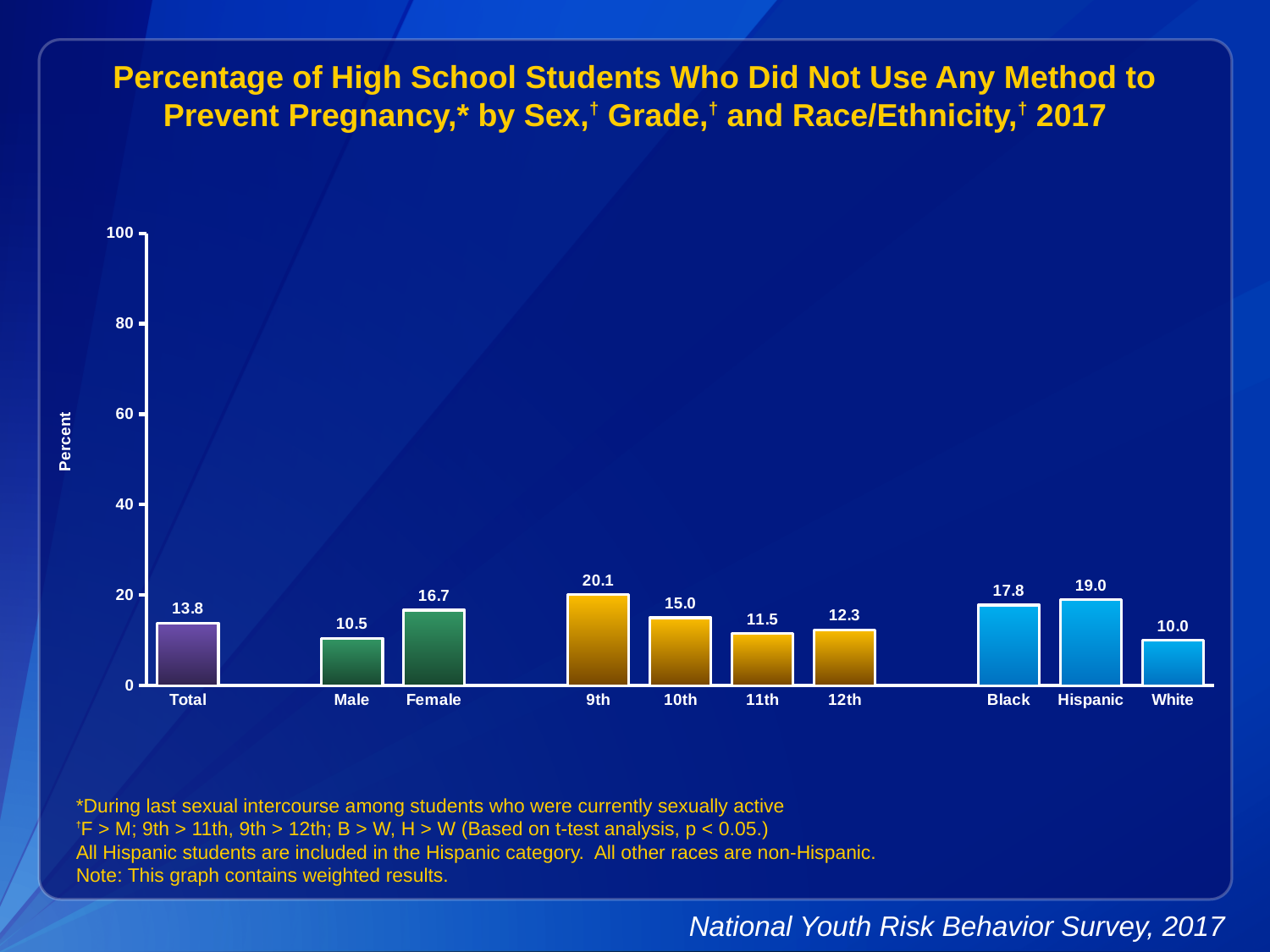
What is the value for Hispanic? 19.0 What is the value for Total? 13.8 Which category has the highest value? 9th What is the label of the y axis? Percent What is the value for 9th grade? 20.1 What is the difference between the Female and Male values? 6.2 Is the value for 9th grade greater or less than 20? greater What is the value for Female? 16.7 Which is larger, the value for Black or the value for Hispanic? Hispanic What kind of chart is this? bar chart Which category has the lowest value? White How many categories are shown on the x axis? 10